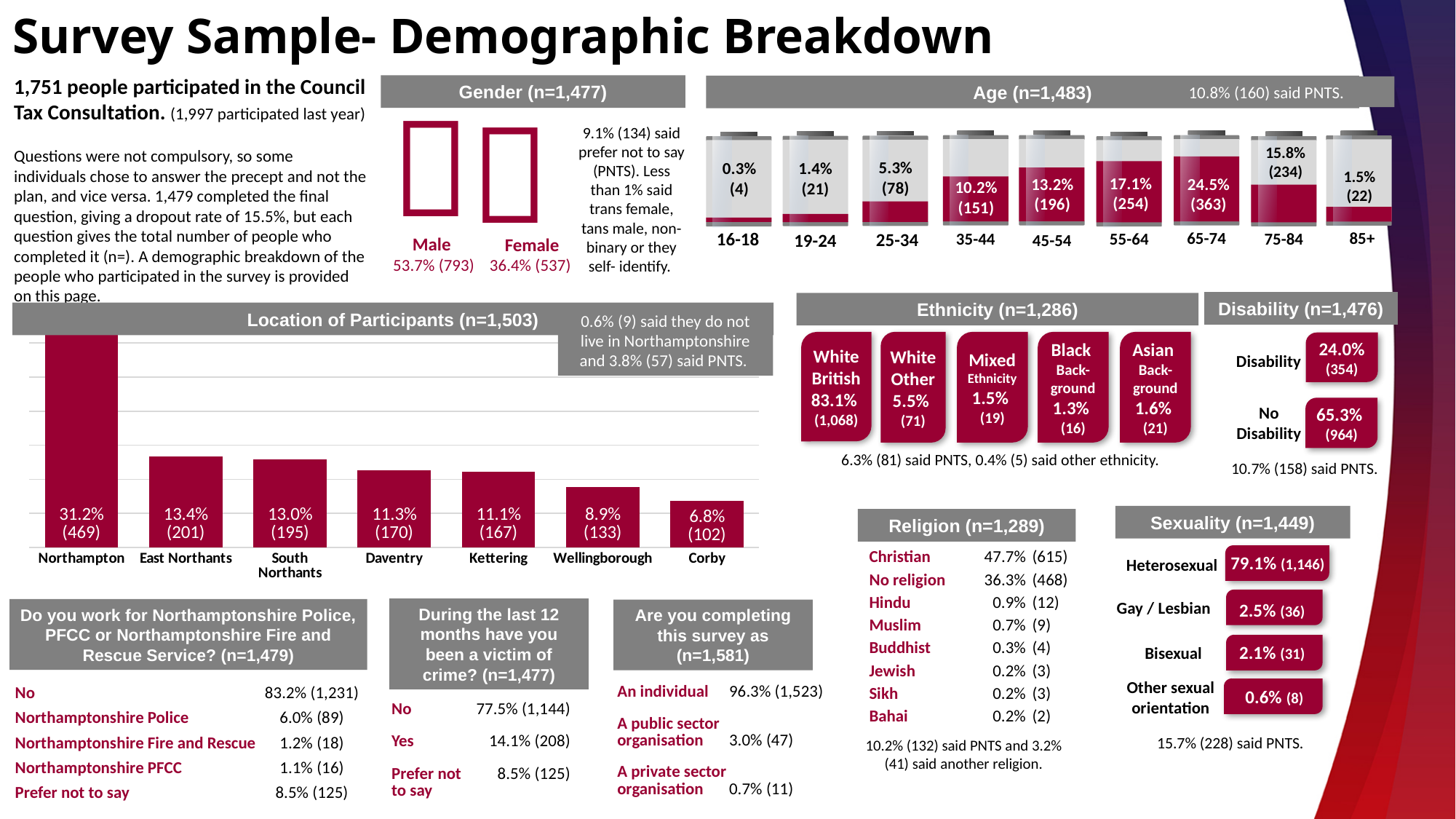
On the Location of Participants chart, which has the larger share of participants, Daventry or Kettering? Daventry On the Location of Participants chart, what is the value shown for Wellingborough? 8.9% (133) On the Location of Participants chart, what is the difference in percentage points between South Northants and Corby? 6.2 What type of chart is the Location of Participants chart? Bar chart In the Age (n=1,483) graphic, which age group has the highest percentage of participants? 65-74 On the Location of Participants chart, do the values rise or fall from left to right? Fall On the Location of Participants chart, how many participants were from Corby? 102 On the Location of Participants chart, which location has the highest share of participants? Northampton On the Location of Participants chart, how many more participants were from Northampton than from East Northants? 268 On the Location of Participants chart, which location has the lowest share of participants? Corby How many locations are shown on the Location of Participants chart? 7 On the Location of Participants chart, what percentage of participants were from Northampton? 31.2%